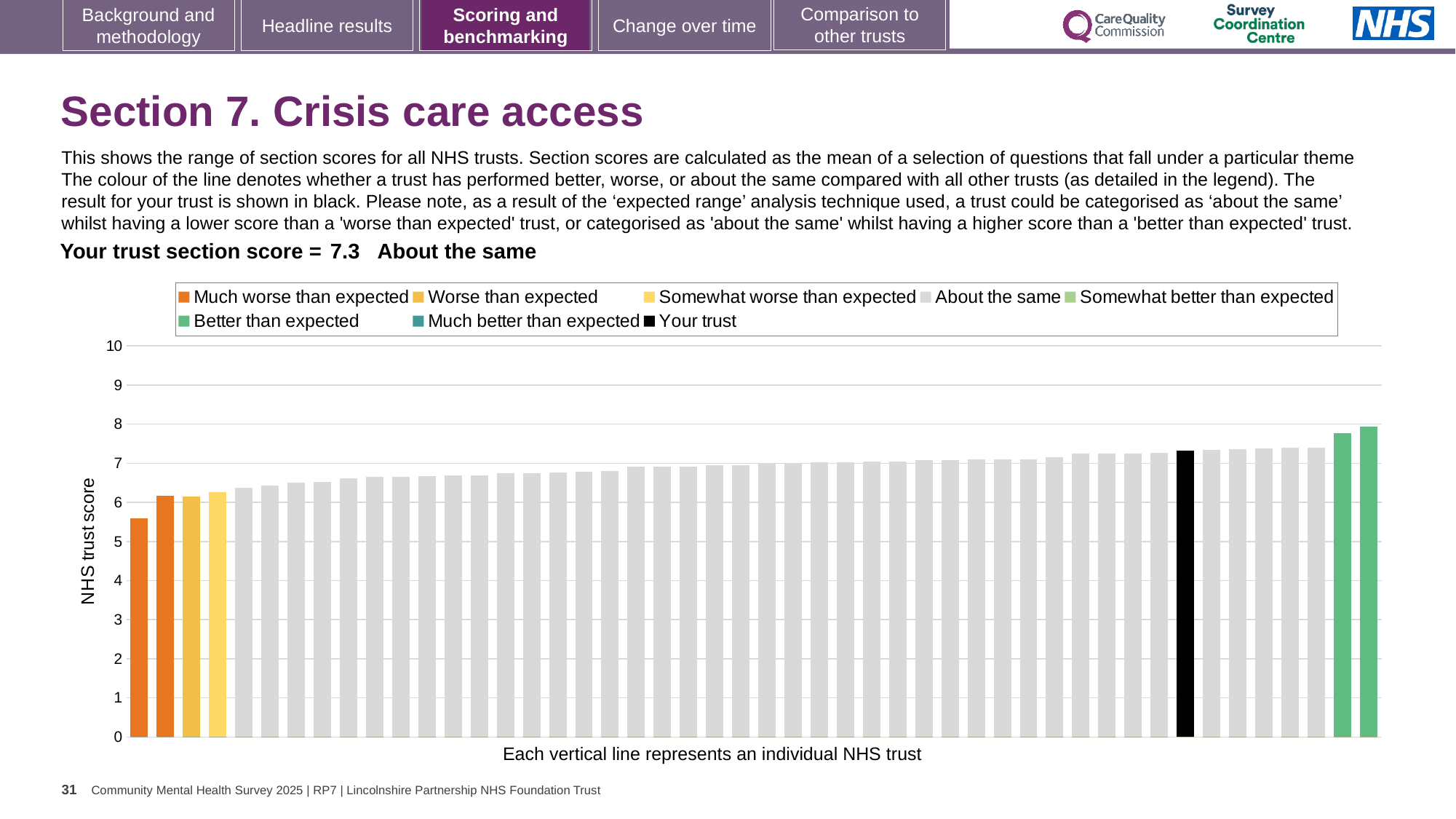
What kind of chart is shown on the slide? bar chart Which legend category does the highest bar in the chart belong to? Better than expected Is the value of the highest bar in the chart greater or less than 7? greater Do the bar values rise or fall from left to right along the x axis? rise What is the section score for your trust shown on the slide? 7.3 Is the value of the lowest bar in the chart greater or less than 6? less What is the label on the vertical axis of the chart? NHS trust score How many entries does the chart legend list? 8 Is the value for your trust (the black bar) greater or less than 7? greater Which legend category does the lowest bar in the chart belong to? Much worse than expected How many bars are coloured as 'Much worse than expected'? 2 Which category is your trust placed in for this section? About the same